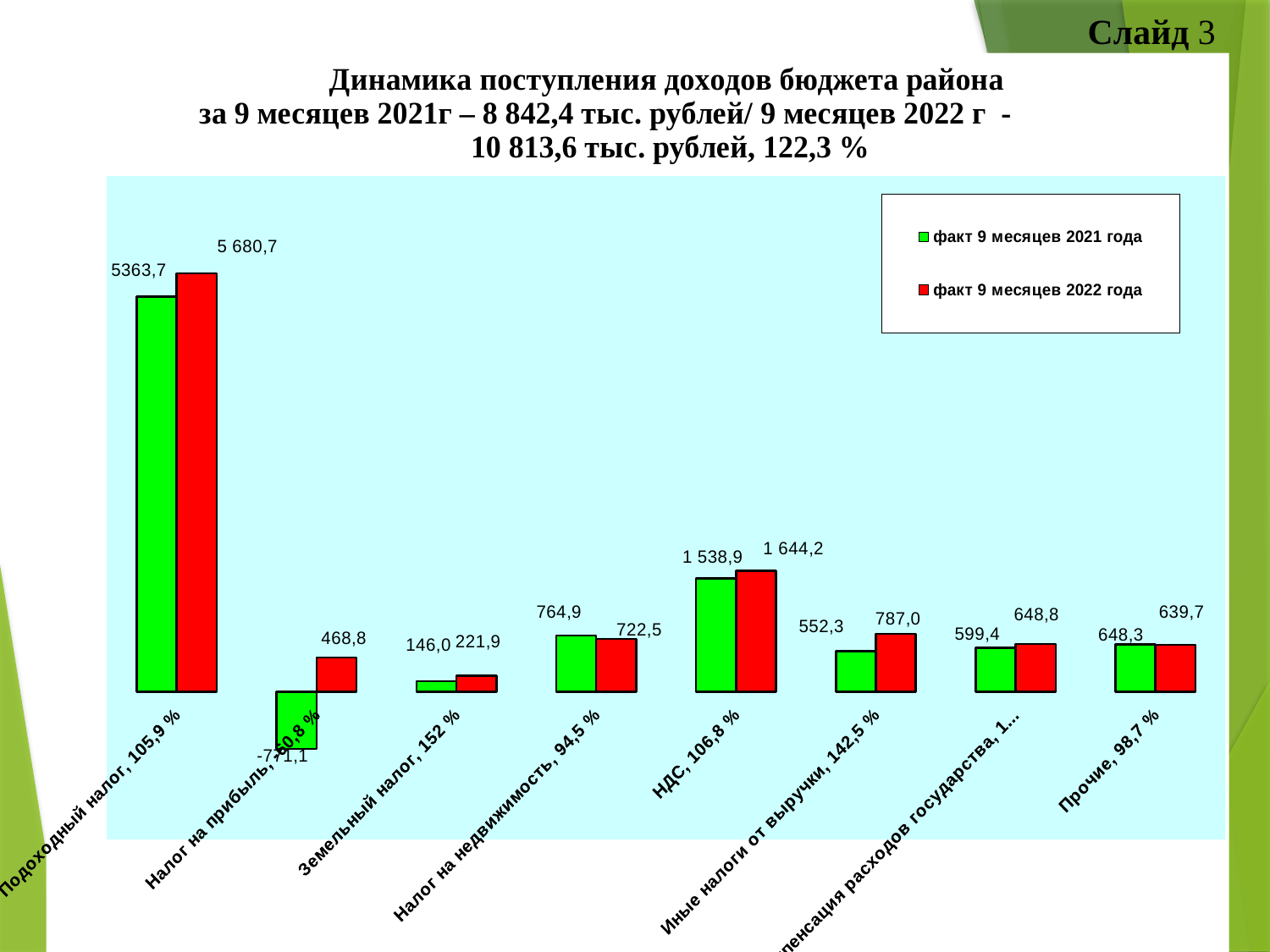
What is the value for Налог на недвижимость in the series факт 9 месяцев 2021 года? 764,9 How many series does the legend list? 2 What is the difference between the 2022 and 2021 values for Иные налоги от выручки? 234,7 What is the value for НДС in the series факт 9 месяцев 2022 года? 1 644,2 What kind of chart is shown on the slide? Bar chart What is the value for Иные налоги от выручки in the series факт 9 месяцев 2022 года? 787,0 What is the difference between the 2022 and 2021 values for Земельный налог? 75,9 Which category has the lowest value in the series факт 9 месяцев 2021 года? Налог на прибыль What is the value for Компенсация расходов государства in the series факт 9 месяцев 2021 года? 599,4 For Прочие, which series has the larger value: факт 9 месяцев 2021 года or факт 9 месяцев 2022 года? факт 9 месяцев 2021 года How many categories are shown on the x axis of the chart? 8 Which category has the highest value in the series факт 9 месяцев 2022 года? Подоходный налог